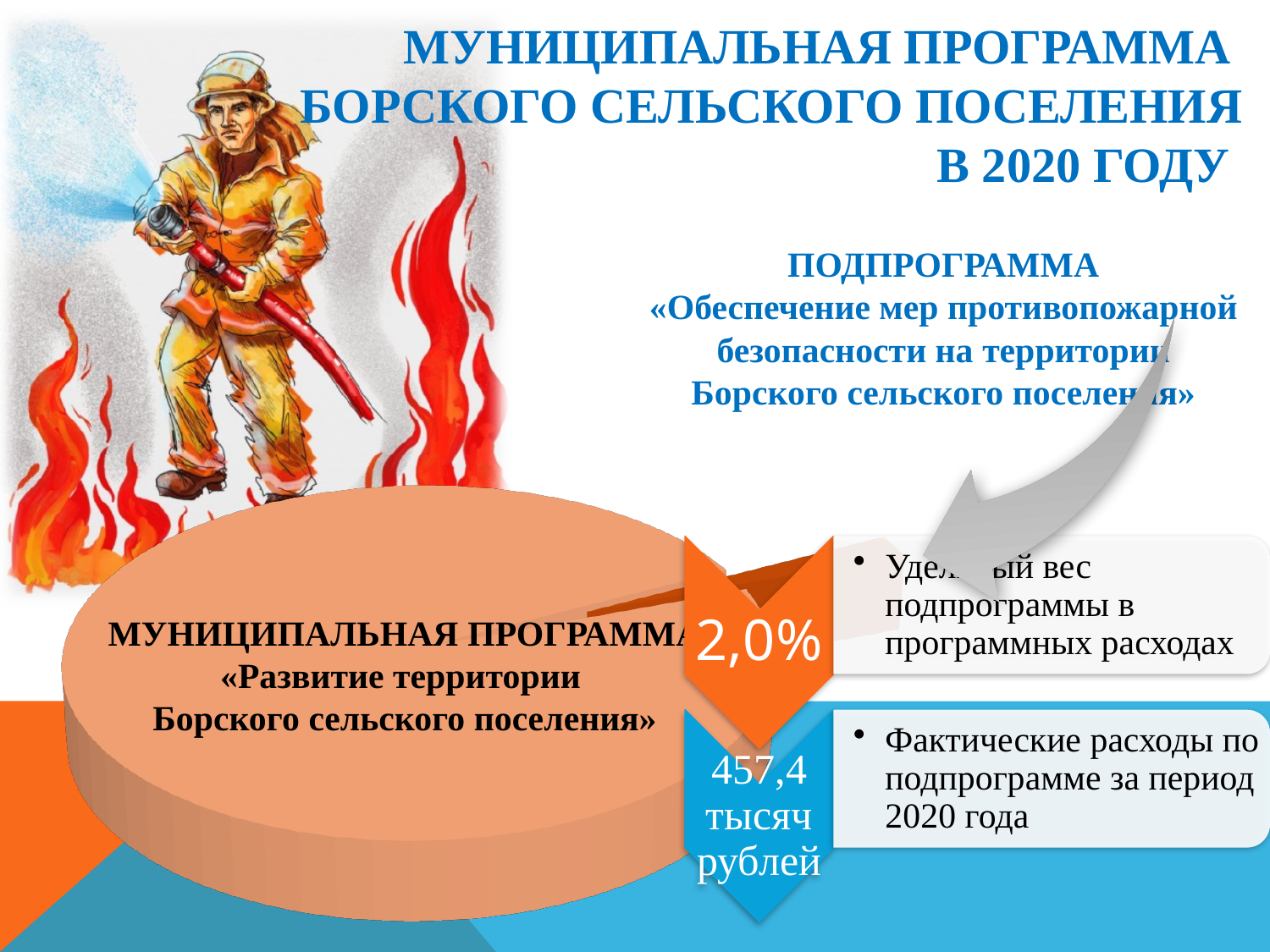
What are the actual expenses for the subprogramme for 2020 shown next to the pie? 457,4 тысяч рублей Which municipal programme does the large pie represent? «Развитие территории Борского сельского поселения» What share of the programme expenditure does the subprogramme slice of the pie represent? 2,0% Which subprogramme does the 2,0% slice of the pie represent? «Обеспечение мер противопожарной безопасности на территории Борского сельского поселения» What kind of chart is used to show the subprogramme's share of programme expenditure? pie chart